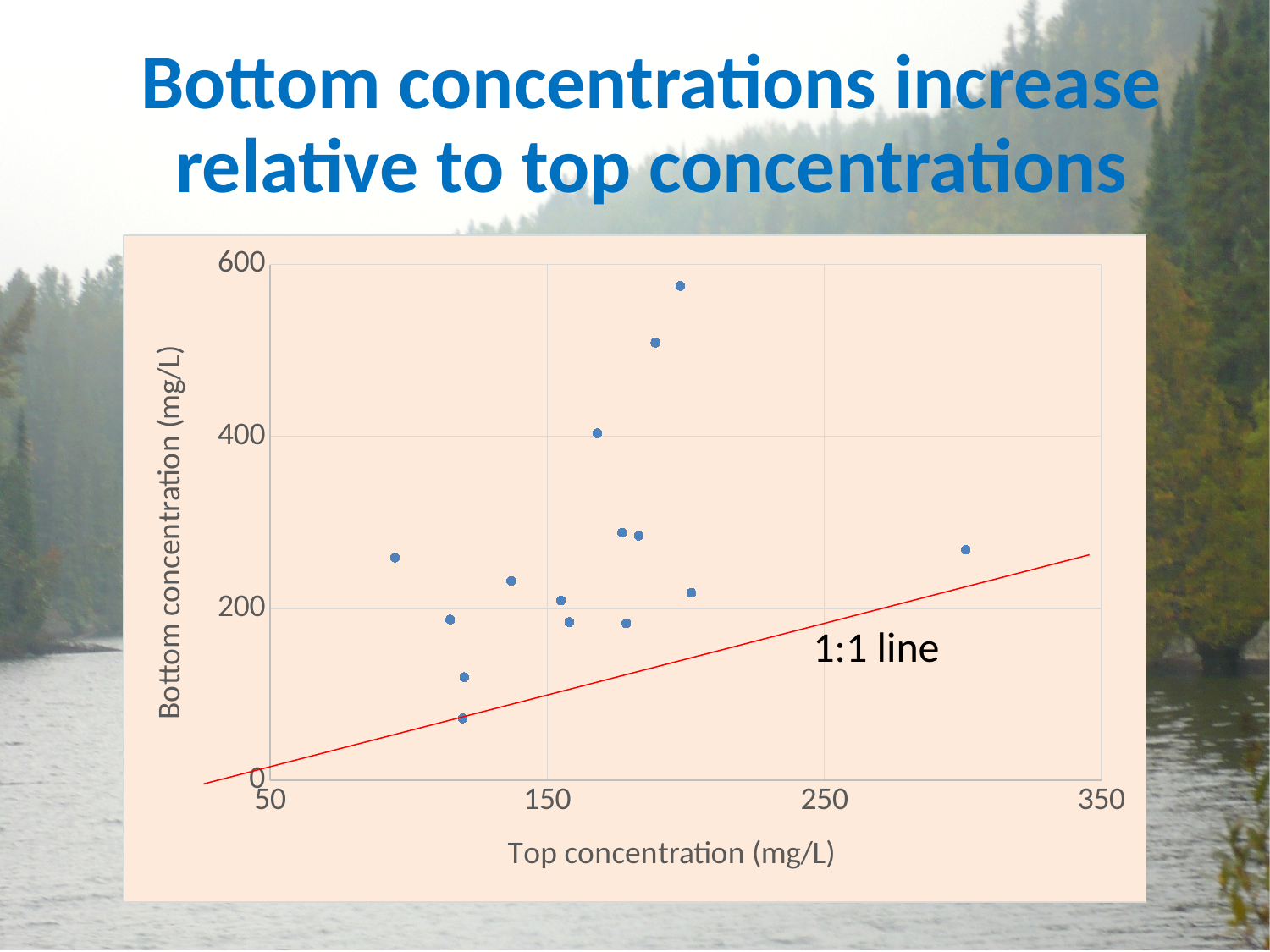
How many points have a bottom concentration greater than 500 mg/L? 2 What is the lowest value shown on the x axis? 50 What is the highest value shown on the y axis? 600 What kind of chart is shown on the slide? scatter plot Do most of the plotted points lie above or below the 1:1 line? above What is the title of the chart's x axis? Top concentration (mg/L) Is the top concentration of the rightmost point greater or less than 250? greater Is the bottom concentration of the highest point greater or less than 400? greater What is the title of the chart's y axis? Bottom concentration (mg/L) Is the bottom concentration of the lowest point greater or less than 200? less What label is given to the red line on the chart? 1:1 line What is the highest value shown on the x axis? 350